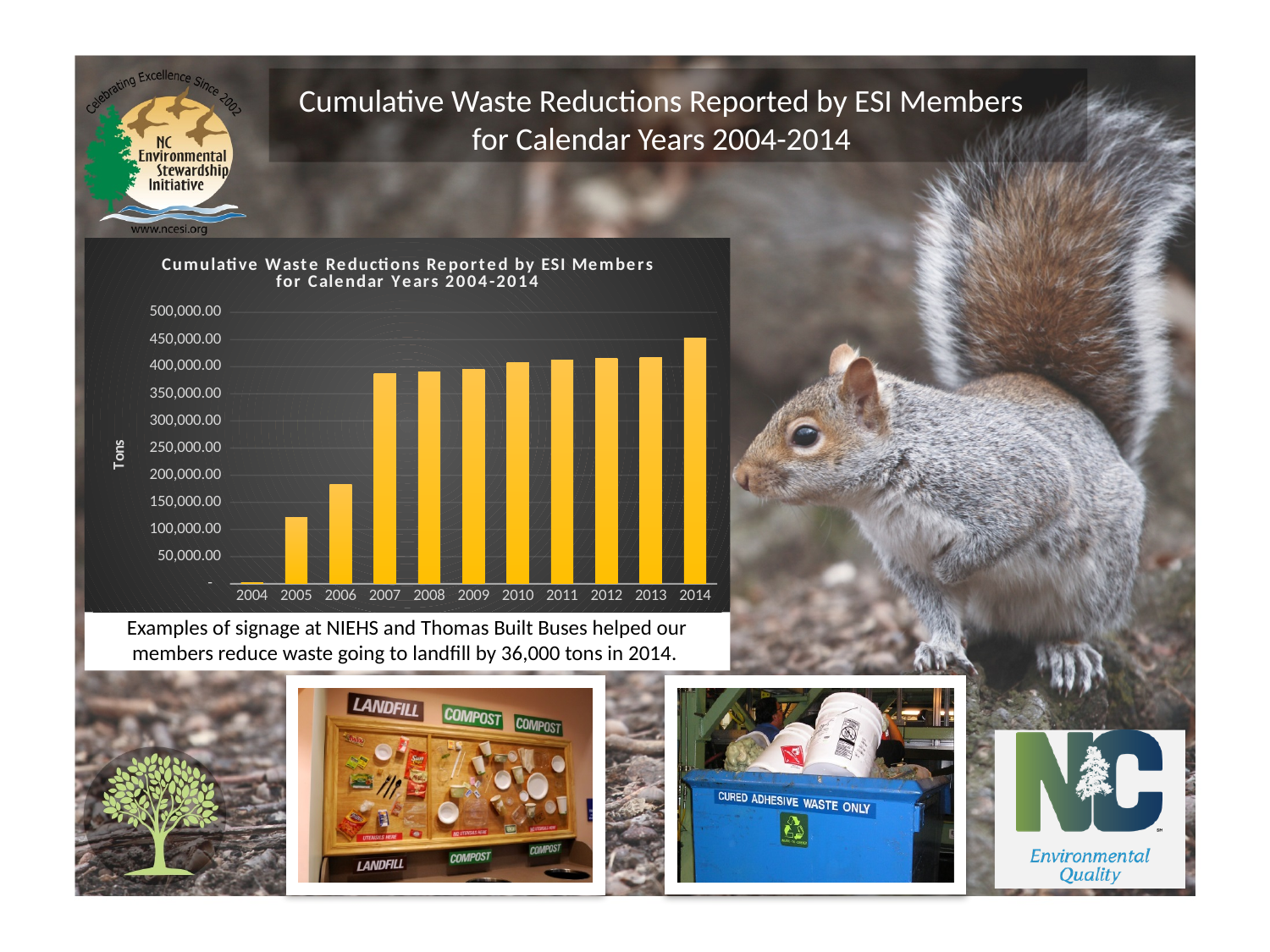
Which year has the highest cumulative waste reduction in the chart? 2014 How many years are plotted on the x axis of the chart? 11 Which year has the larger value, 2013 or 2014? 2014 Is the value for 2006 greater or less than 200,000.00? less Which year has the lowest cumulative waste reduction in the chart? 2004 What kind of chart is shown on the slide? bar chart Is the value for 2014 greater or less than 500,000.00? less Is the value for 2007 greater or less than 350,000.00? greater Which year has the larger value, 2006 or 2007? 2007 What is the label on the vertical axis of the chart? Tons Do the values in the chart rise or fall from 2004 to 2014? rise